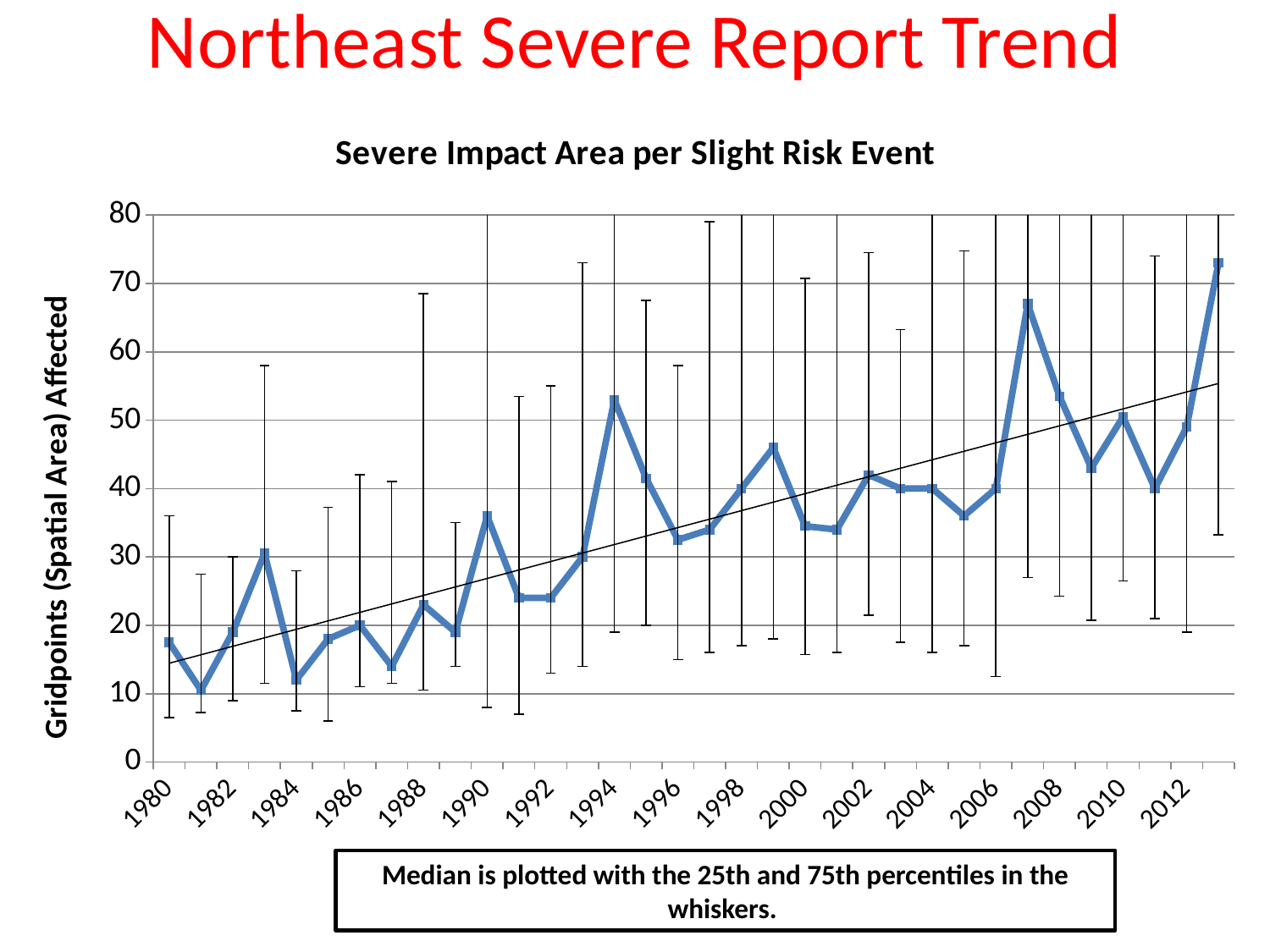
Which year has the larger median value, 1990 or 1994? 1994 Is the median value for 1994 greater or less than 50? greater Which year has the highest median value on the chart? 2013 Does the trend line show values rising or falling from 1980 to 2013? rising Is the median value for 2000 greater or less than 40? less Is the median value for 2007 greater or less than 60? greater Which year has the larger median value, 2007 or 2008? 2007 What is the label on the vertical axis of the chart? Gridpoints (Spatial Area) Affected What type of chart is shown on the slide? line chart What is the title of the chart? Severe Impact Area per Slight Risk Event